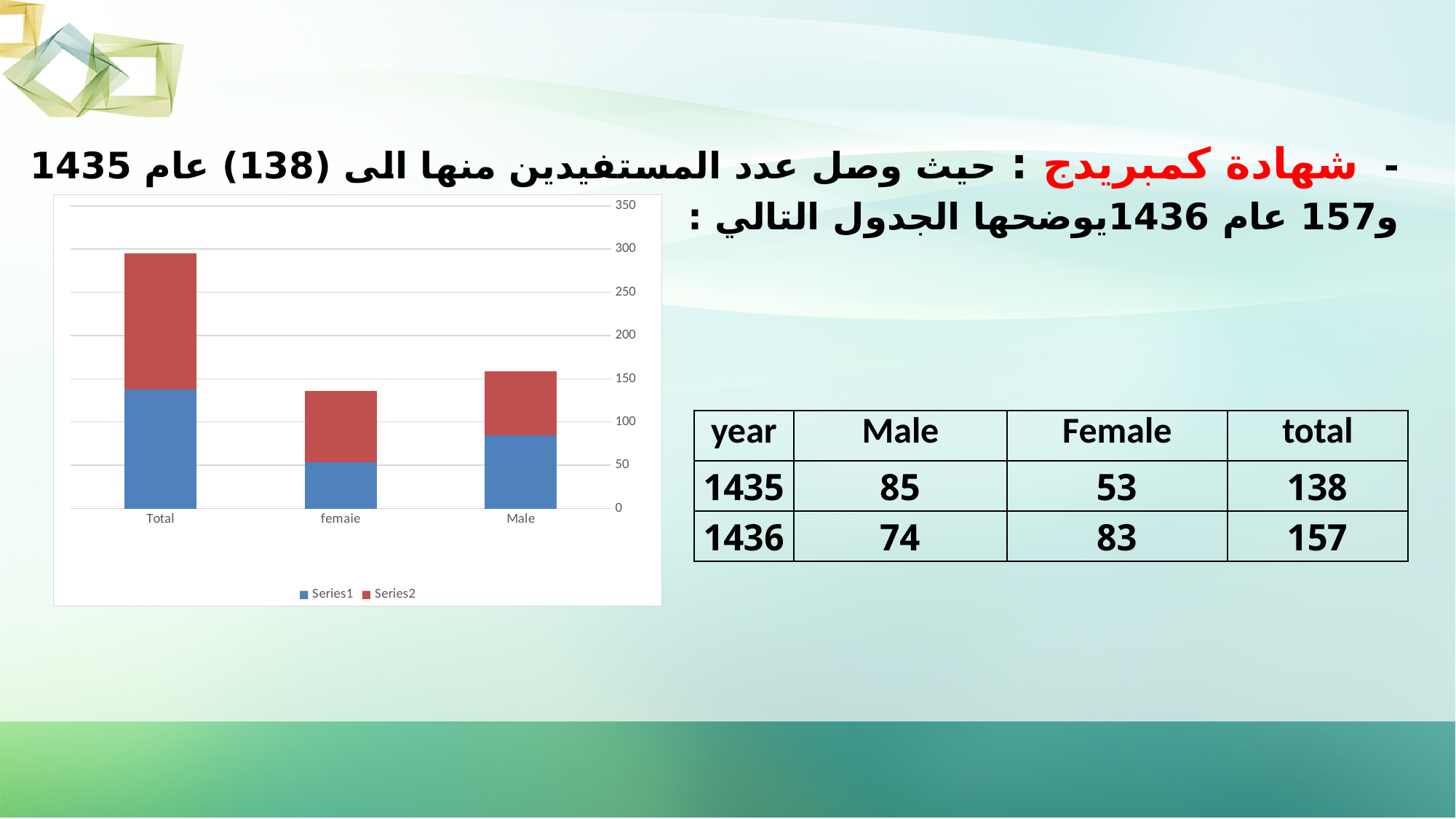
Which category has the shortest stacked bar in the chart? femaie Which category has the tallest stacked bar in the chart? Total Is the Series1 value for Male greater or less than 100? less Which is larger, the stacked bar for Male or the stacked bar for femaie? Male Is the total height of the stacked bar for Total greater or less than 250? greater How many series does the chart legend list? 2 What kind of chart is shown on the slide? bar chart Is the total height of the stacked bar for femaie greater or less than 150? less Which is larger, the Series1 value for Total or the Series1 value for Male? Total What colour represents Series1 in the chart? blue How many categories are shown on the x axis of the chart? 3